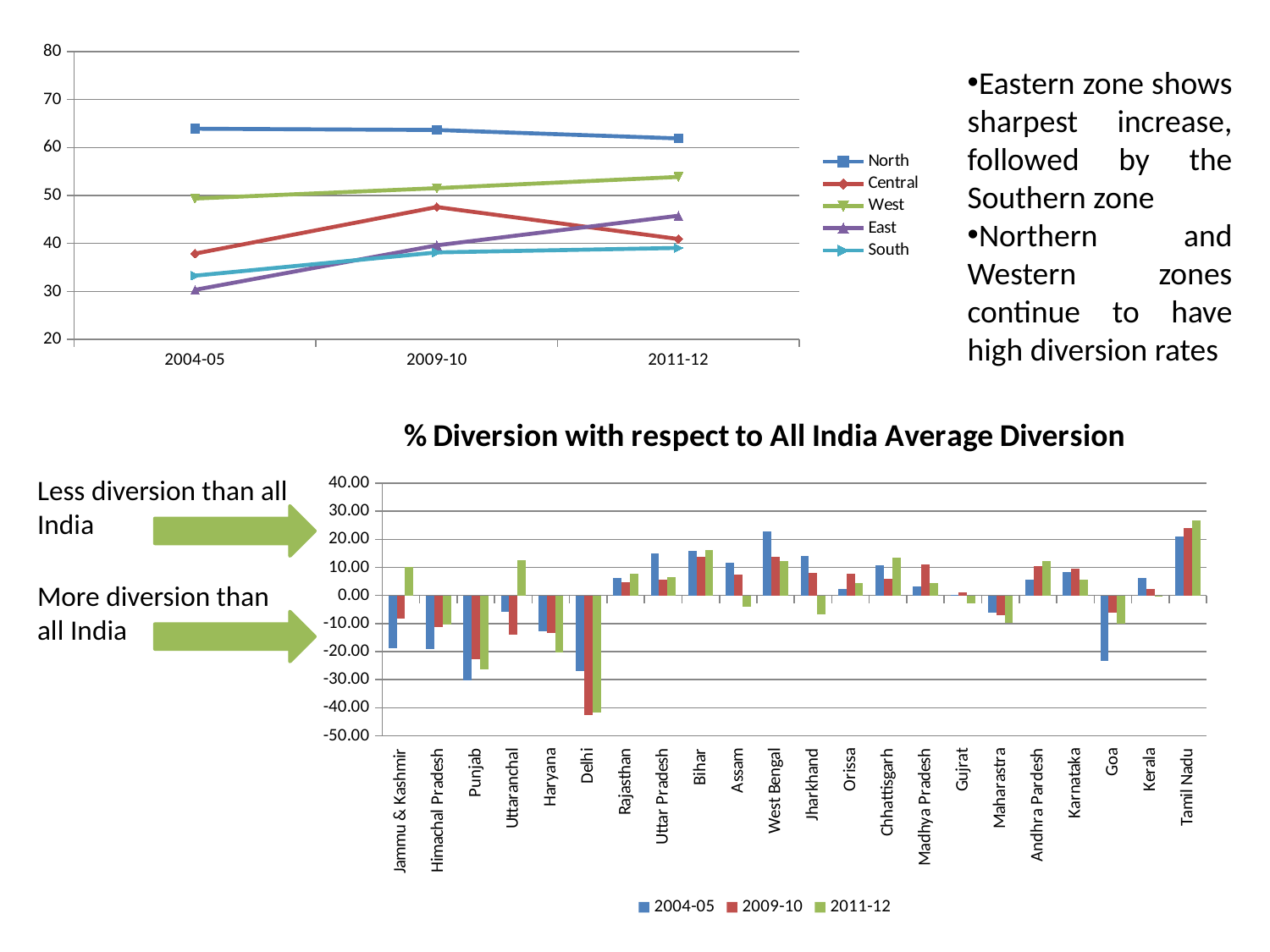
In the top line chart, which zone has the highest value in 2004-05? North In the chart '% Diversion with respect to All India Average Diversion', how many series does the legend list? 3 In the top line chart, how many series does the legend list? 5 In the top line chart, which zone has the lowest value in 2004-05? East What kind of chart is the top chart showing the zones North, Central, West, East and South? line chart In the top line chart, does the North line rise or fall from 2004-05 to 2011-12? fall What kind of chart is '% Diversion with respect to All India Average Diversion'? bar chart In the top line chart, is the value for East in 2011-12 greater or less than 40? greater In the chart '% Diversion with respect to All India Average Diversion', which state has the lowest bar? Delhi In the top line chart, which is larger in 2011-12, East or South? East In the chart '% Diversion with respect to All India Average Diversion', how many states are shown on the x axis? 22 In the chart '% Diversion with respect to All India Average Diversion', is the 2004-05 value for Goa greater or less than -20.00? less